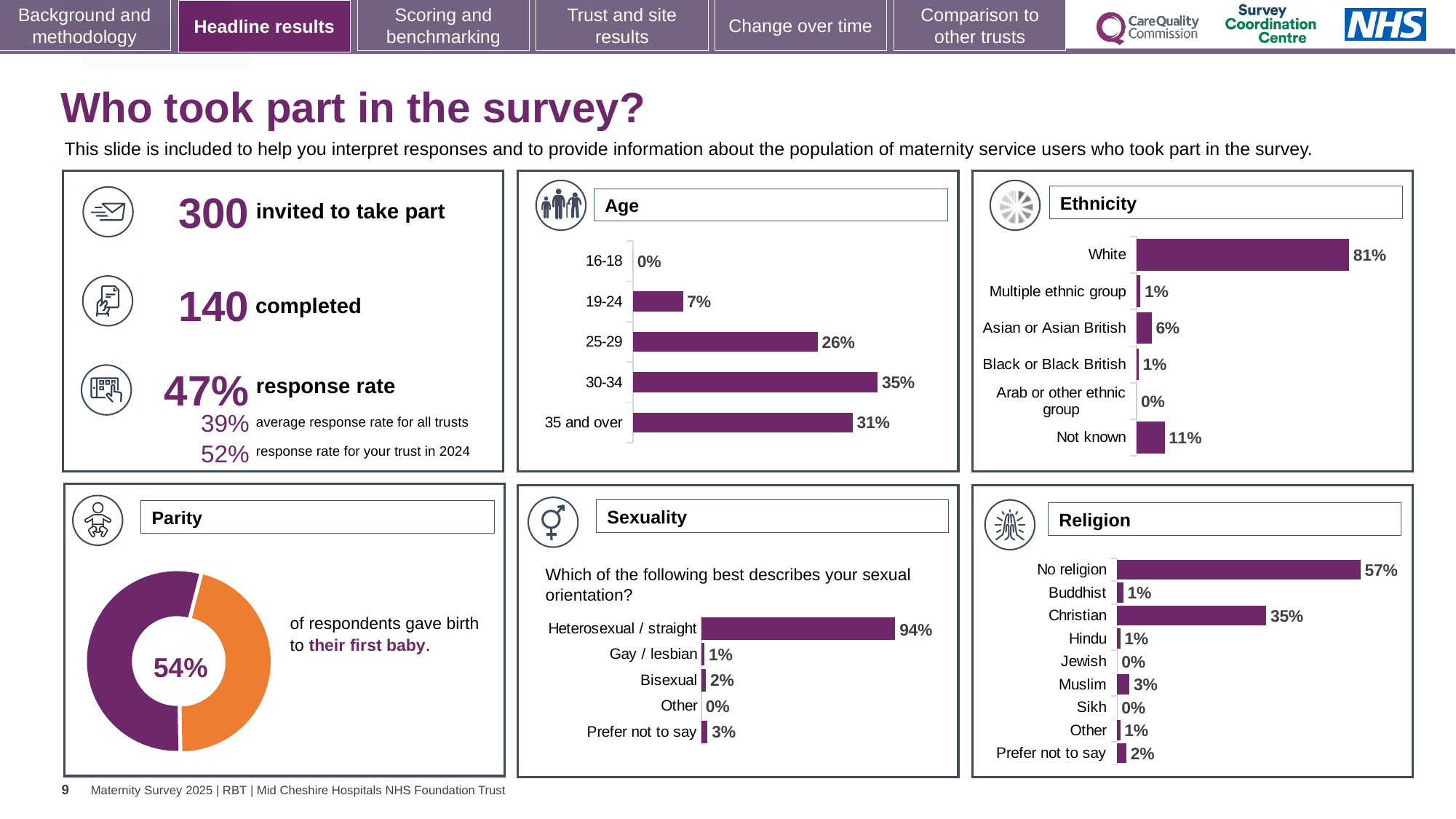
In the Sexuality chart, what percentage of respondents answered Heterosexual / straight? 94% In the Parity chart, what percentage of respondents gave birth to their first baby? 54% In the Religion chart, what percentage of respondents were Christian? 35% In the Religion chart, how many categories are shown? 9 In the Ethnicity chart, which is larger: Asian or Asian British or Black or Black British? Asian or Asian British In the Religion chart, which category has the highest percentage? No religion What kind of chart is the Parity chart? Doughnut chart In the Ethnicity chart, what is the difference between the White and Not known percentages? 70% In the Age chart, which age group has the highest percentage? 30-34 In the Ethnicity chart, what percentage of respondents were White? 81% In the Age chart, what percentage of respondents were aged 30-34? 35% In the Age chart, how many age categories are shown? 5